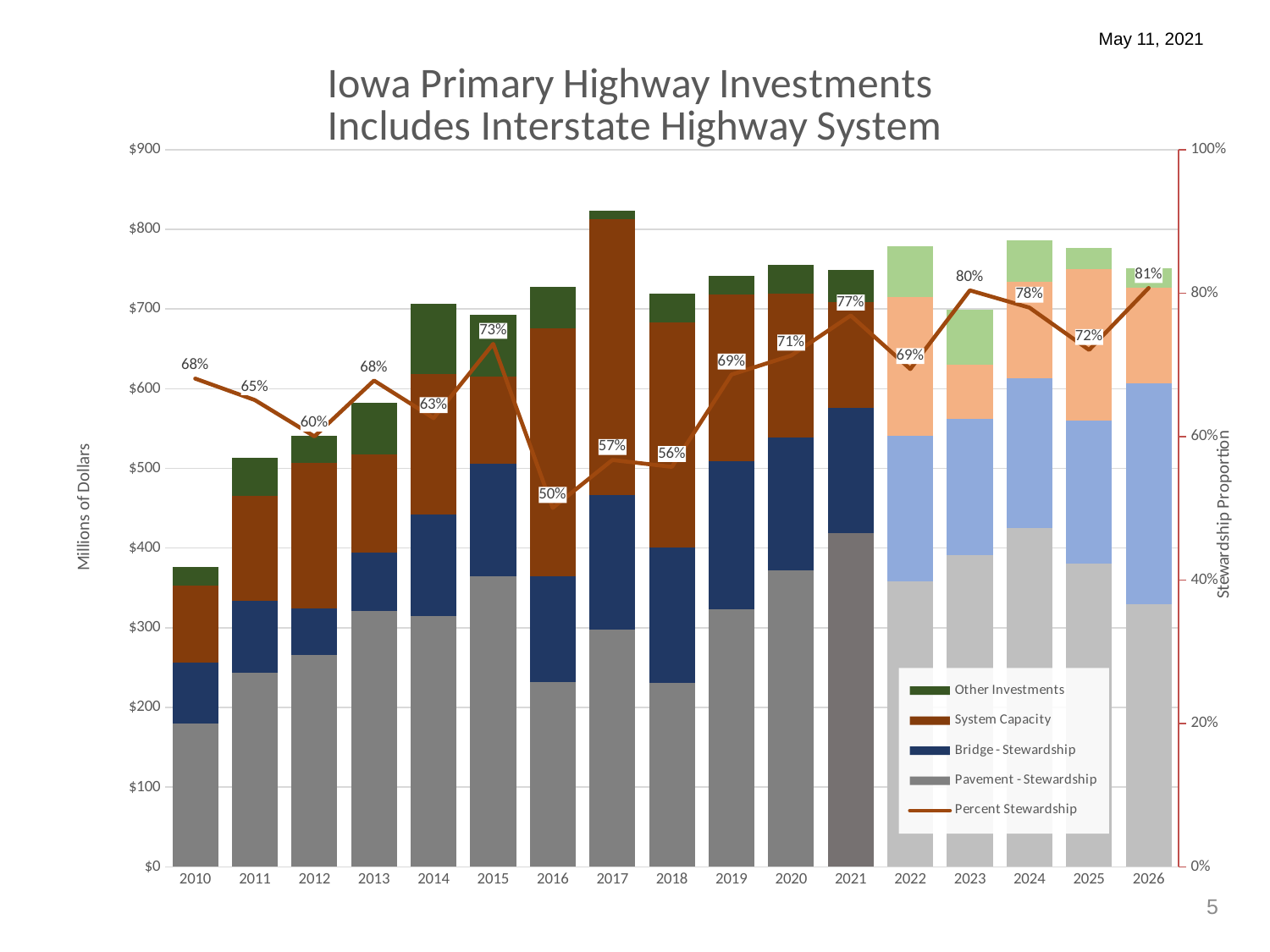
Which year has a higher Percent Stewardship value, 2015 or 2018? 2015 How many years are shown on the x axis? 17 Which year has the highest Percent Stewardship value? 2026 Is the total investment bar for 2017 greater or less than $800? greater What is the label of the left vertical axis? Millions of Dollars Is the total investment bar for 2010 greater or less than $400? less Which year has the lowest Percent Stewardship value? 2016 What is the Percent Stewardship value for 2023? 80% What is the Percent Stewardship value for 2016? 50% How many series does the legend list? 5 What is the Percent Stewardship value for 2021? 77% What is the difference between the Percent Stewardship values for 2026 and 2016? 31%